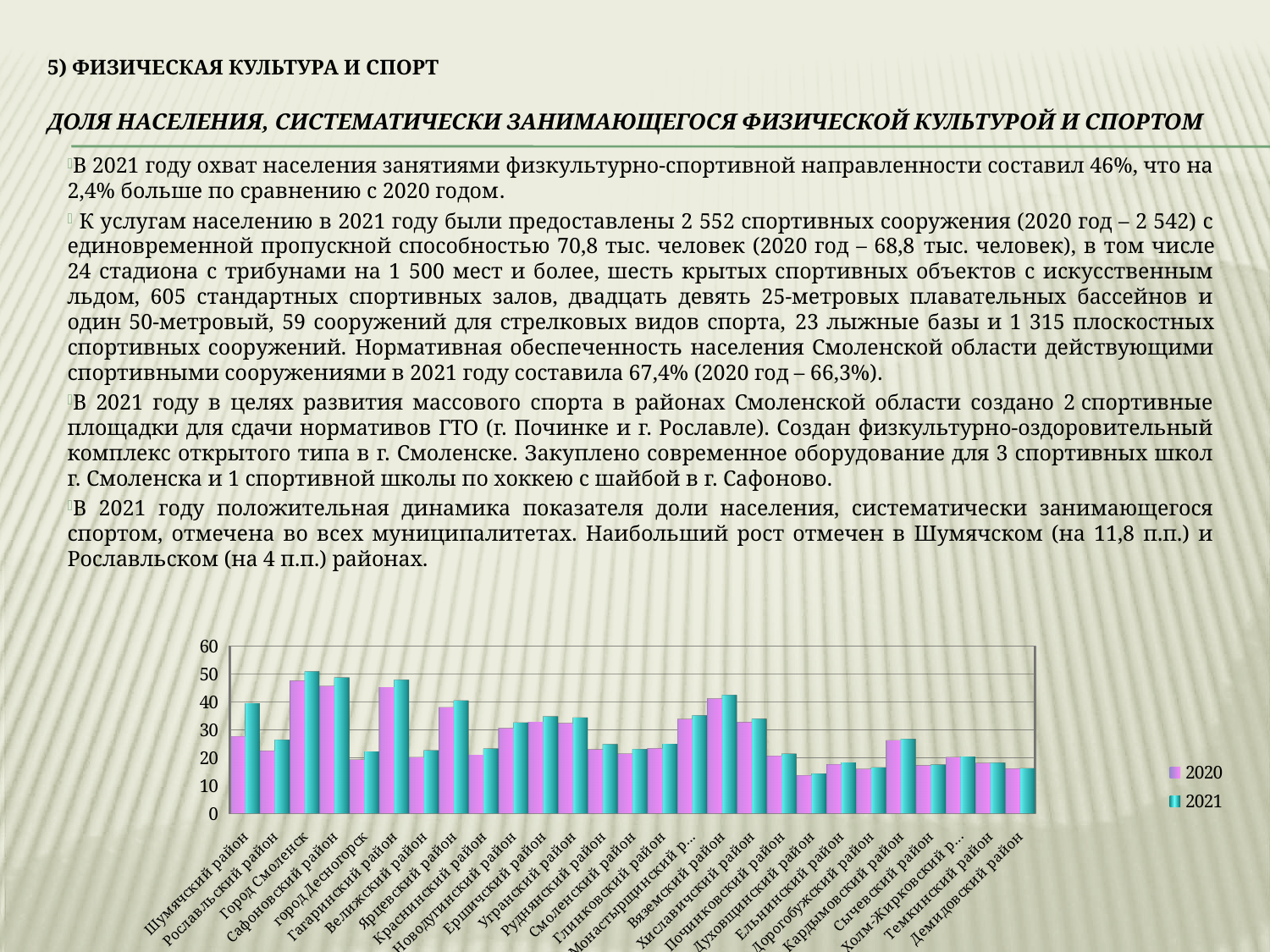
For Шумячский район, which is larger: the 2020 value or the 2021 value? 2021 Is the 2021 value for Сафоновский район greater or less than 40? greater Which category has the lowest bar in the chart? Духовщинский район Is the 2020 value for Ельнинский район greater or less than 20? less Which has the larger 2021 value: Вяземский район or Починковский район? Вяземский район Which two series are listed in the chart legend? 2020 and 2021 How many districts (categories) are shown on the x axis of the chart? 27 Is the 2020 value for Шумячский район greater or less than 30? less How many series does the chart legend list? 2 What kind of chart is shown on the slide? bar chart Which category has the highest bar in the chart? Город Смоленск